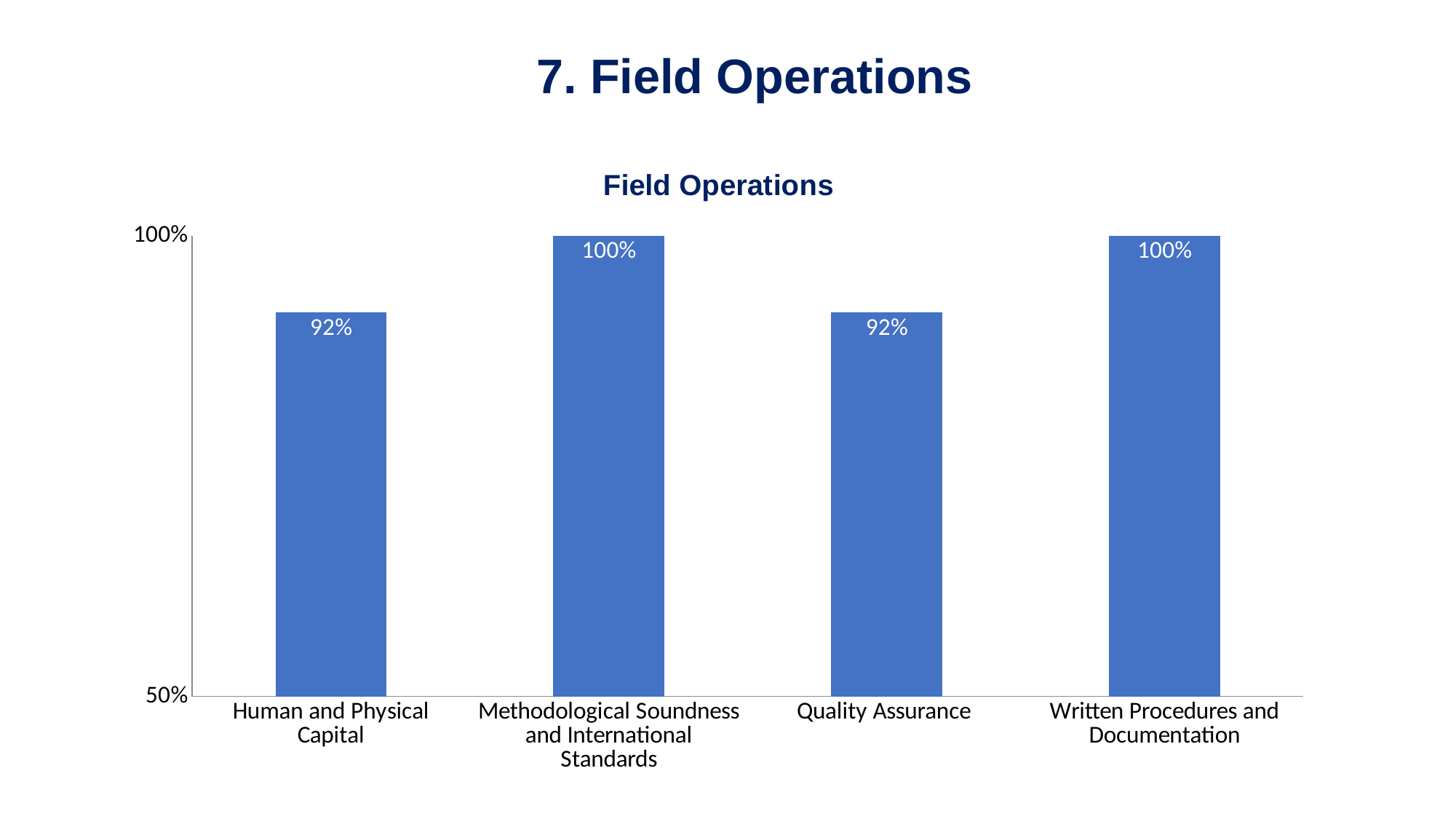
What is the lowest value shown on the vertical axis? 50% What is the value for Methodological Soundness and International Standards? 100% What is the value for Human and Physical Capital? 92% Which categories have the highest value? Methodological Soundness and International Standards and Written Procedures and Documentation What is the title of the chart? Field Operations Which is larger, the value for Written Procedures and Documentation or the value for Human and Physical Capital? Written Procedures and Documentation How many categories are shown on the chart? 4 What is the value for Quality Assurance? 92% What is the value for Written Procedures and Documentation? 100% Which categories have the lowest value? Human and Physical Capital and Quality Assurance What is the difference between the values for Methodological Soundness and International Standards and Quality Assurance? 8% What kind of chart is shown on the slide? Bar chart